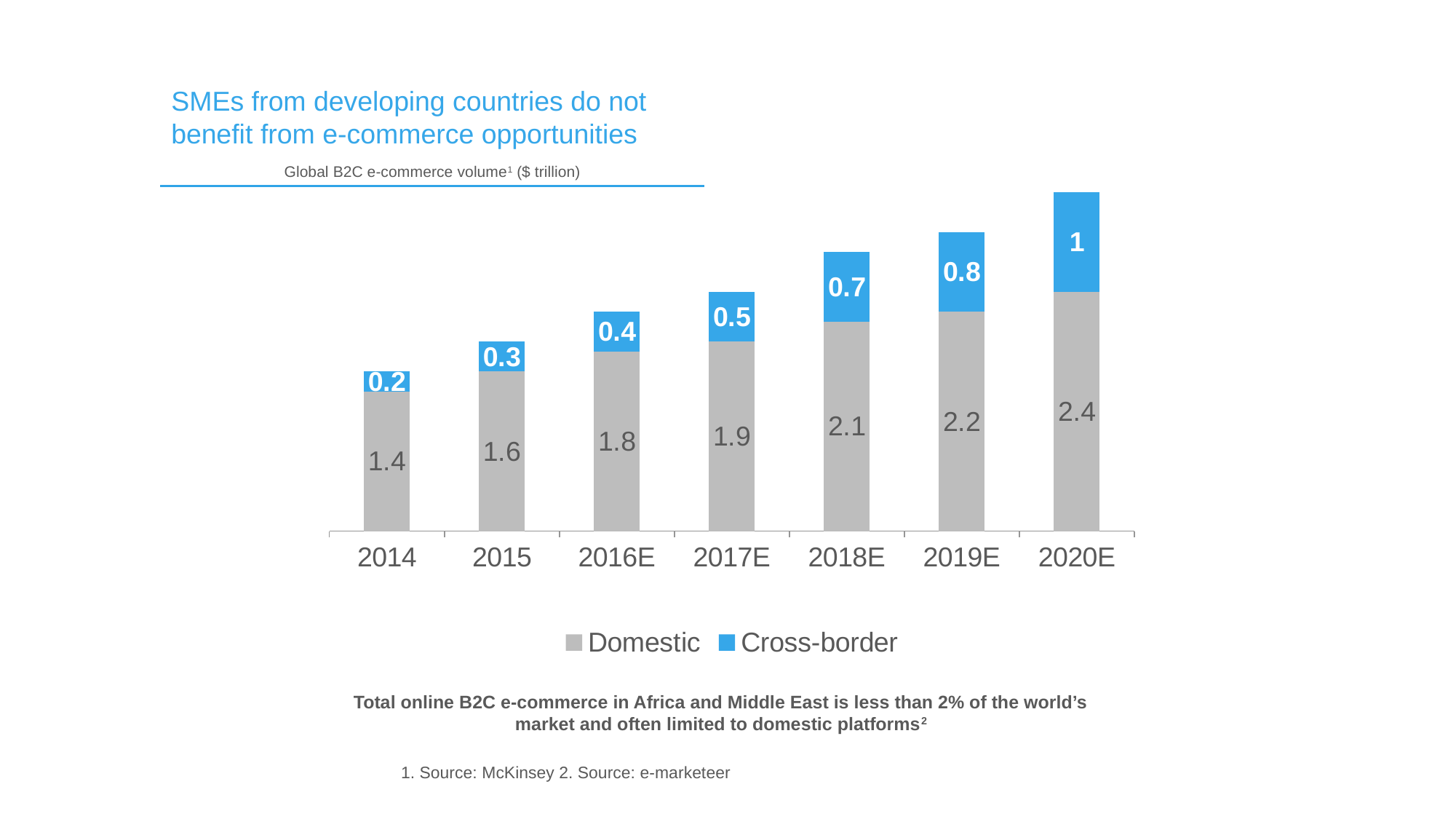
What is the total of the stacked bar for 2020E? 3.4 What is the total of the stacked bar for 2015? 1.9 Which is larger, the Cross-border value for 2017E or for 2019E? 2019E What is the Cross-border value for 2018E? 0.7 How many years are shown on the x axis? 7 Which year has the lowest Cross-border value? 2014 Which year has the highest Domestic value? 2020E Do the Domestic values rise or fall from 2014 to 2020E? rise What is the Domestic value for 2014? 1.4 How many series does the legend list? 2 What is the difference between the Domestic values for 2020E and 2014? 1.0 What is the Cross-border value for 2020E? 1